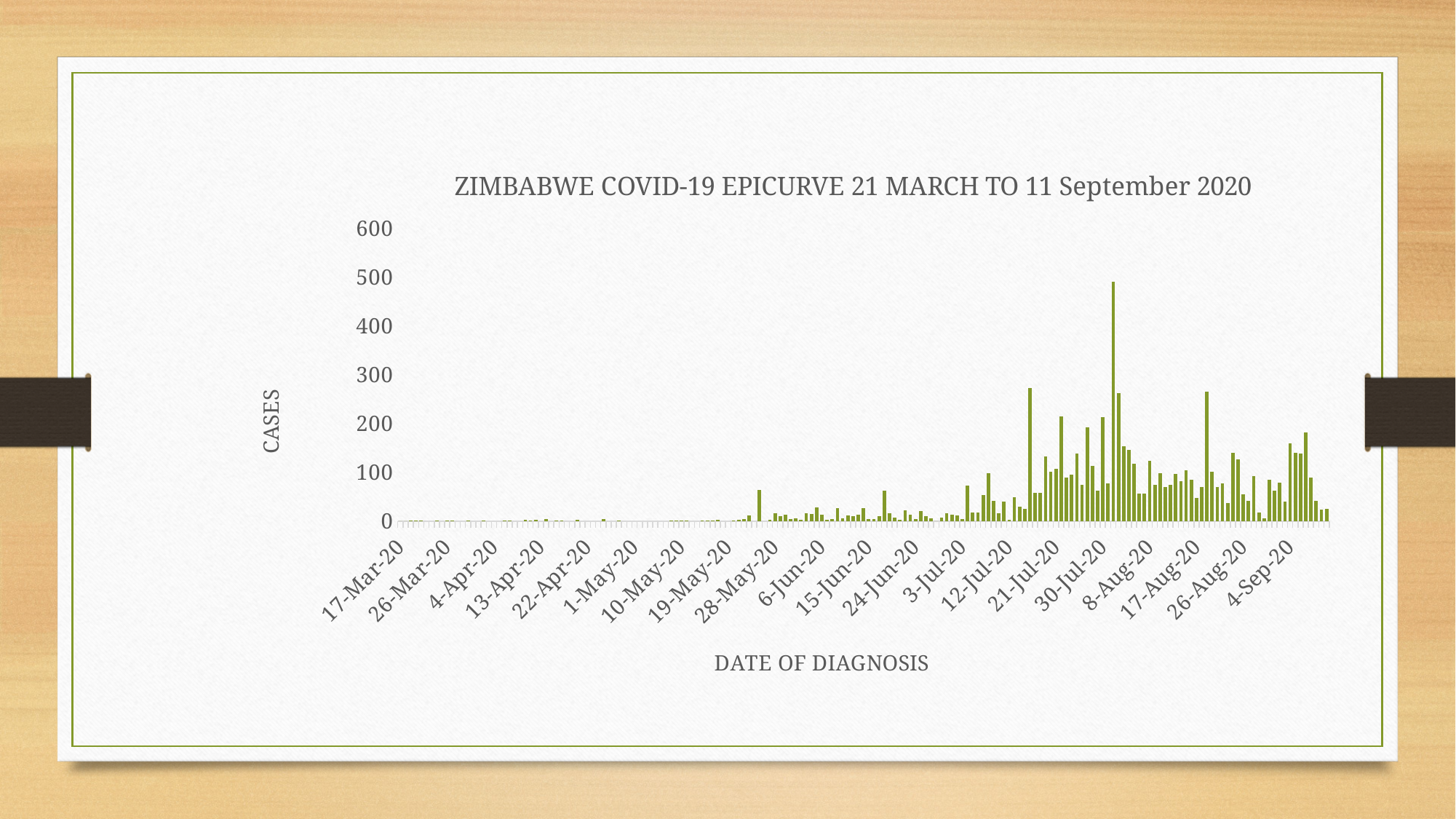
What is the highest value shown on the vertical axis? 600 What is the title of the chart? ZIMBABWE COVID-19 EPICURVE 21 MARCH TO 11 September 2020 Between which two labelled dates does the tallest bar in the chart fall? between 30-Jul-20 and 8-Aug-20 Is the value for 4-Apr-20 greater or less than 100? less Is the value of the tallest bar in the chart greater or less than 400? greater What kind of chart is shown on the slide? bar chart What is the label on the vertical axis of the chart? CASES How many data series are plotted in the chart? 1 Are daily cases higher around 4-Apr-20 or around 8-Aug-20? around 8-Aug-20 Do daily cases generally rise or fall from March 2020 to late July 2020? rise